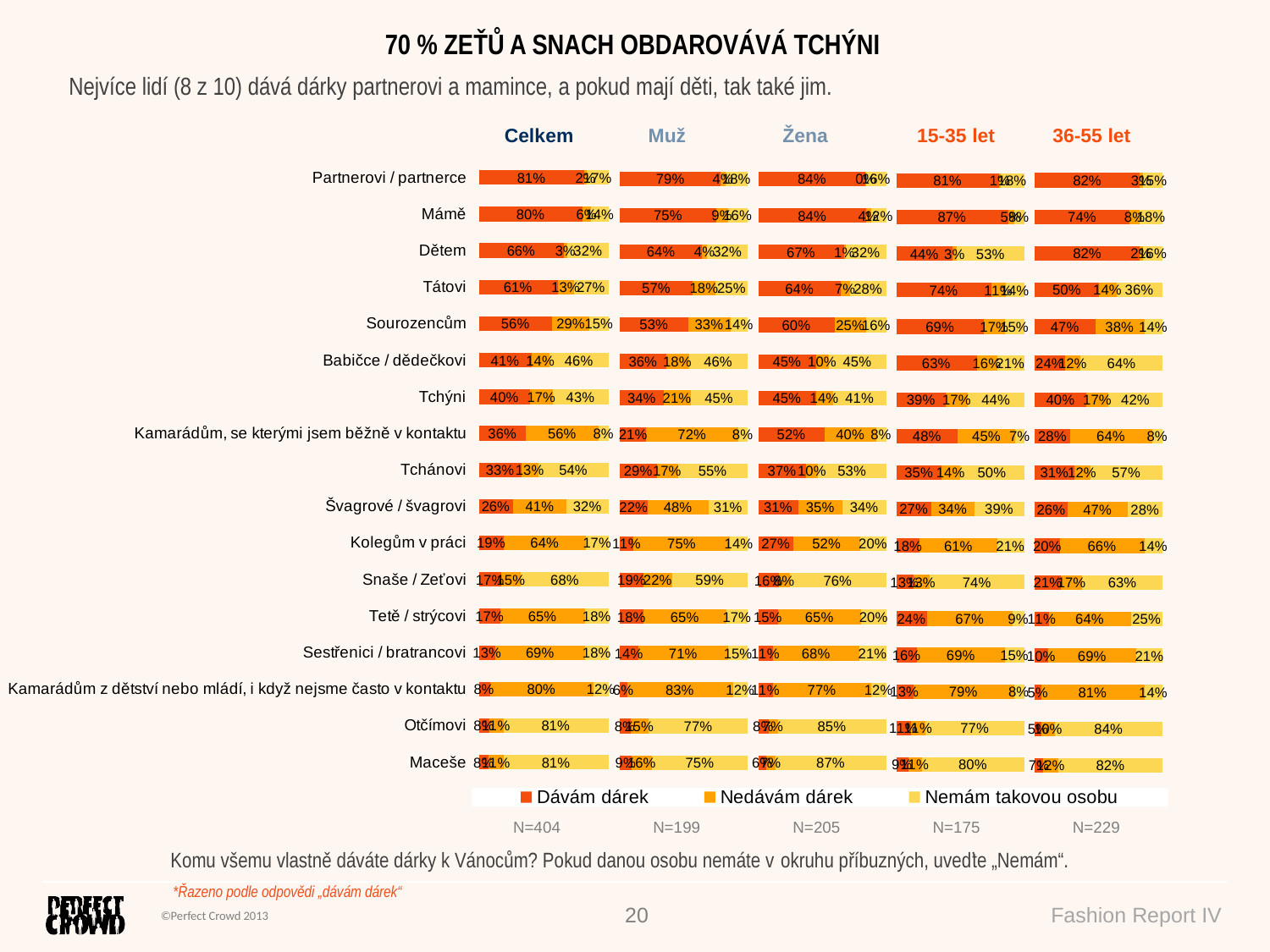
What kind of chart is used on this slide? Stacked bar chart In the 15-35 let chart, what is the "Dávám dárek" value for Babičce / dědečkovi? 63% What is the difference between the "Dávám dárek" value for Mámě in the 15-35 let chart and in the 36-55 let chart? 13 percentage points In the 15-35 let chart, which category has the highest "Dávám dárek" value? Mámě How many categories (recipients) are listed on the vertical axis of the charts? 17 In the Celkem chart, what percentage of respondents answered "Dávám dárek" for Tchýni? 40% In the Celkem chart, what is the "Nemám takovou osobu" value for Snaše / Zeťovi? 68% In the Muž chart, what is the "Dávám dárek" value for Mámě? 75% In the Žena chart, what is the "Dávám dárek" value for Sourozencům? 60% In the 36-55 let chart, what is the "Dávám dárek" value for Dětem? 82% How many series does the legend list? 3 In the Celkem chart, which has the larger "Dávám dárek" value: Tátovi or Sourozencům? Tátovi